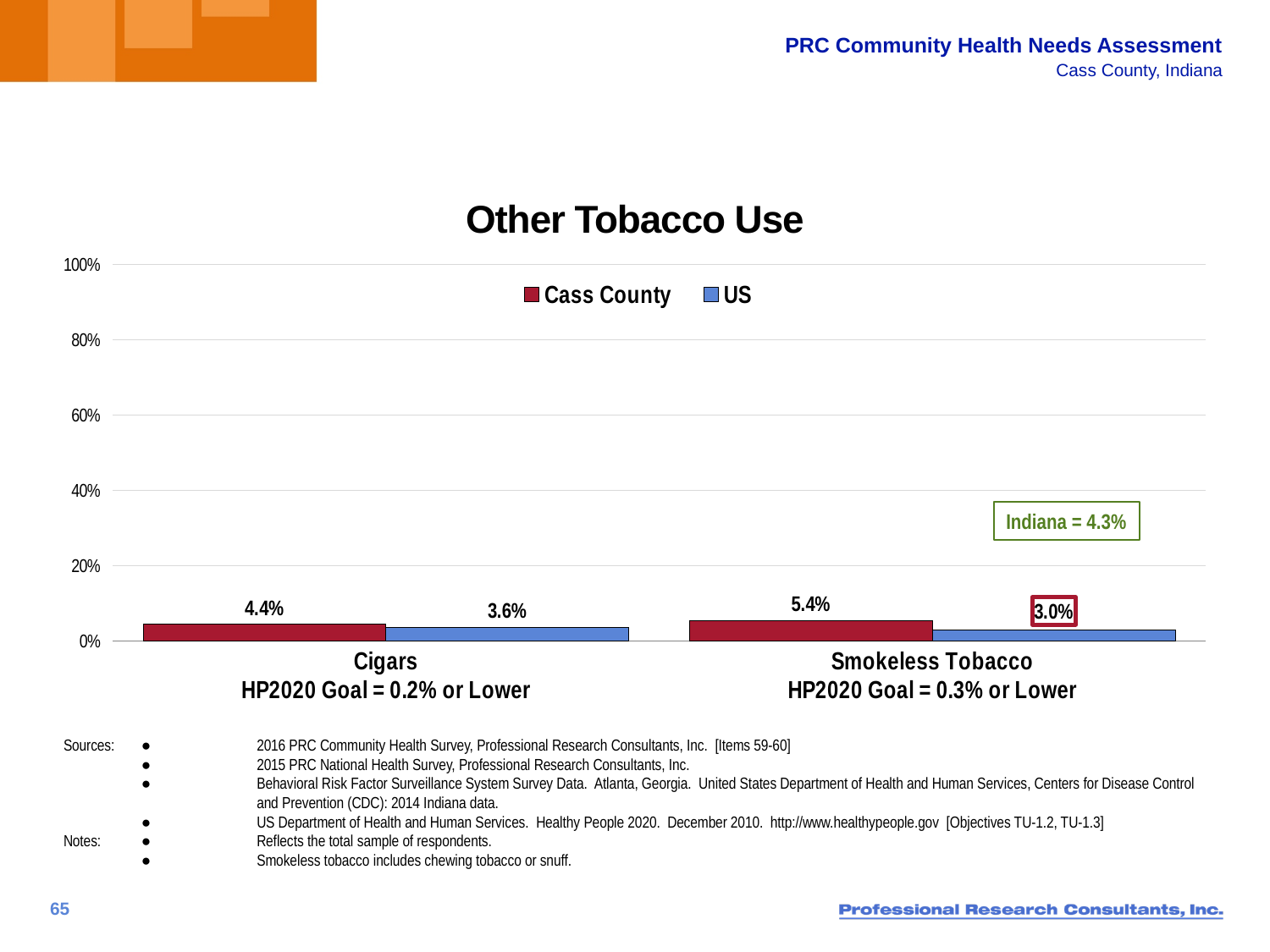
What is the Cass County value for Smokeless Tobacco? 5.4% Is the Cass County value for Smokeless Tobacco greater or less than 20%? less How many series does the legend list? 2 What is the US value for Cigars? 3.6% Which is larger for Cigars, the Cass County value or the US value? Cass County What is the difference between the Cass County and US values for Smokeless Tobacco? 2.4% How many categories are shown on the x axis? 2 Which category has the lowest US value? Smokeless Tobacco Which category has the highest Cass County value? Smokeless Tobacco What kind of chart is shown on the slide? bar chart What is the Cass County value for Cigars? 4.4% What is the US value for Smokeless Tobacco? 3.0%